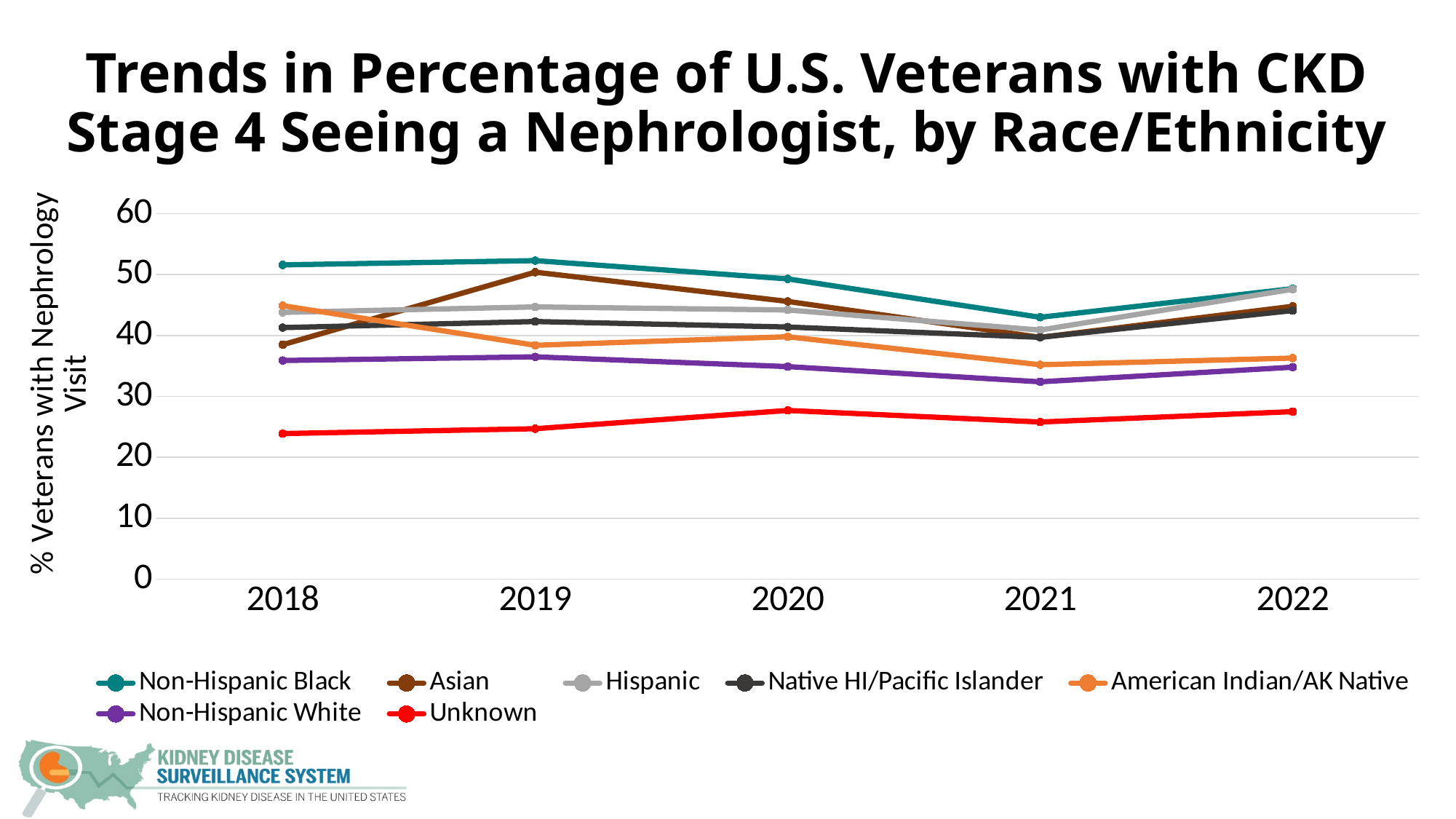
How many series does the legend list? 7 In which year is the Non-Hispanic Black series at its lowest? 2021 Which race/ethnicity group has the highest value in 2018? Non-Hispanic Black In 2019, which is larger: the value for Asian or the value for Non-Hispanic White? Asian Is the value for Non-Hispanic White in 2021 greater or less than 40? less Which race/ethnicity group has the lowest value in 2018? Unknown What is the label on the y axis? % Veterans with Nephrology Visit Does the Unknown series rise or fall from 2018 to 2020? rise Does the Non-Hispanic Black series rise or fall from 2019 to 2021? fall How many years are plotted along the x axis? 5 What kind of chart is shown on the slide? line chart Is the value for Unknown in 2020 greater or less than 30? less